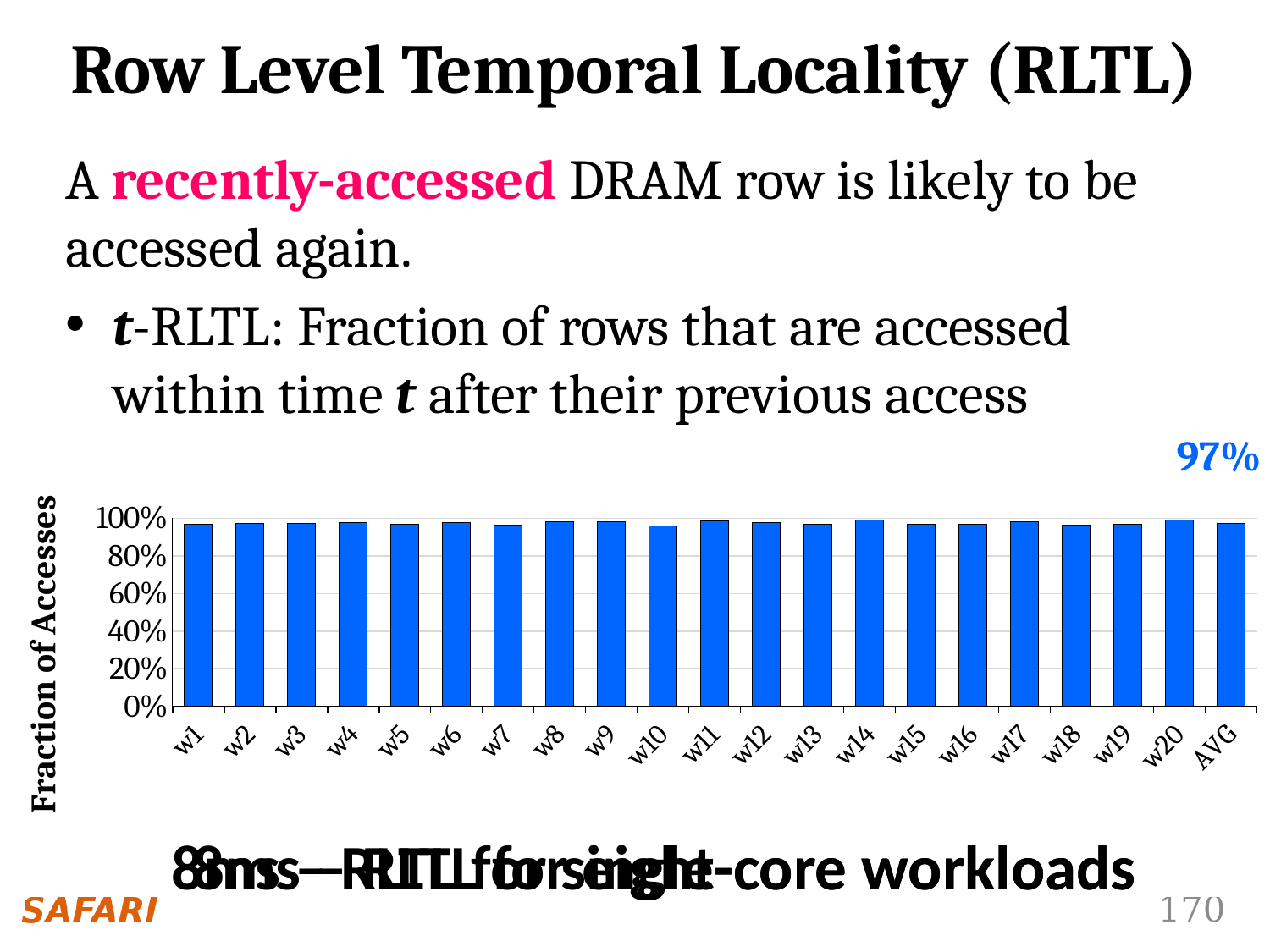
What is the value shown for AVG in the chart? 97% Is the value for w14 greater or less than 40%? greater Is the value for w10 greater or less than 60%? greater Is the value for w1 greater or less than 80%? greater What kind of chart is shown on the slide? bar chart What is the label of the vertical axis of the chart? Fraction of Accesses How many categories are plotted along the x axis of the chart? 21 What is the label of the last category on the x axis of the chart? AVG What is the highest tick value shown on the vertical axis of the chart? 100%